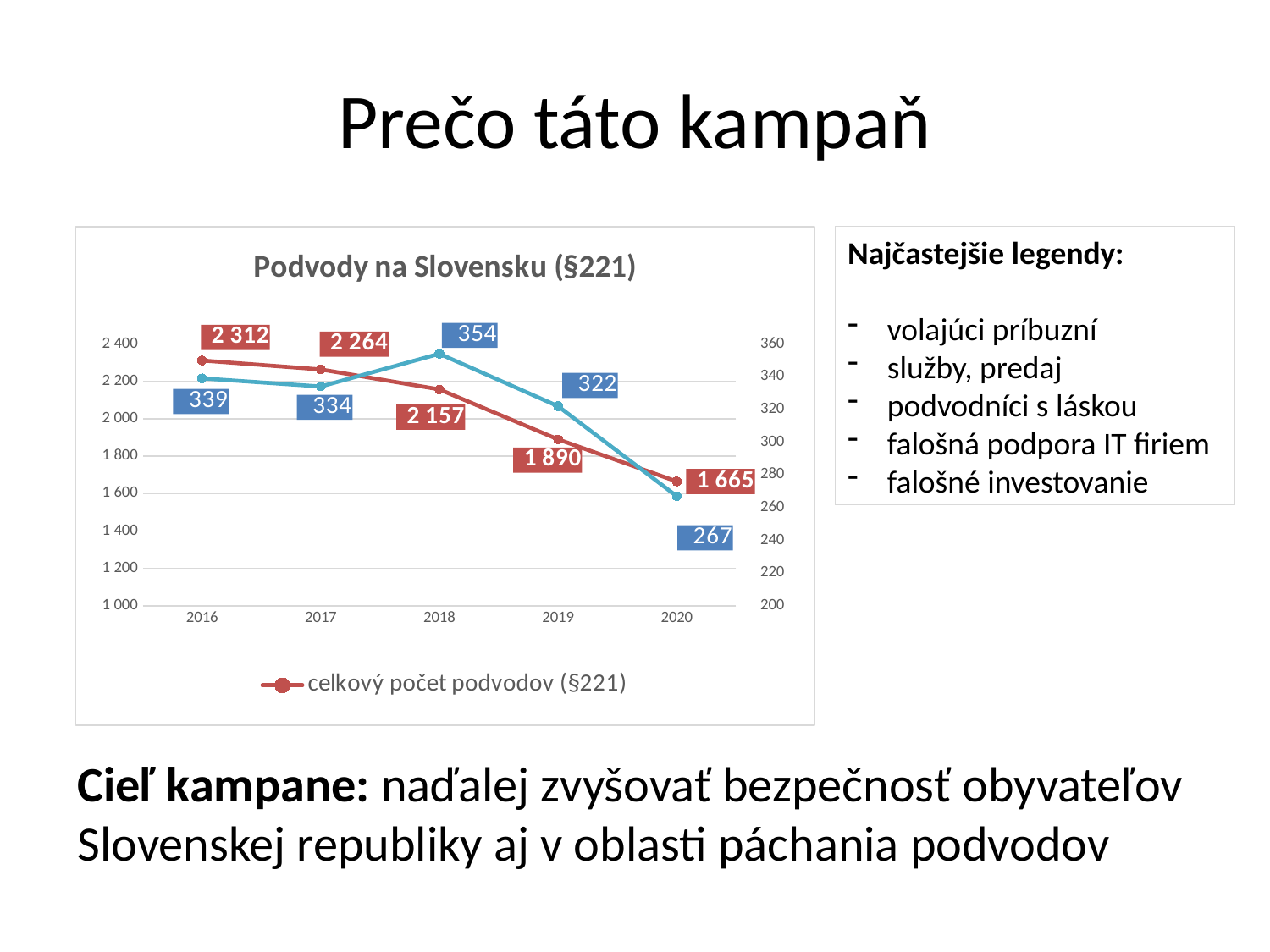
What is the value of celkový počet podvodov (§221) in 2020? 1 665 Which year has a larger value of celkový počet podvodov (§221), 2017 or 2019? 2017 In which year is celkový počet podvodov (§221) highest? 2016 Does celkový počet podvodov (§221) rise or fall from 2016 to 2020? fall What type of chart is shown on the slide? line chart What is the title of the chart? Podvody na Slovensku (§221) How many years are shown on the x axis of the chart? 5 What is the value of celkový počet podvodov (§221) in 2018? 2 157 In which year is celkový počet podvodov (§221) lowest? 2020 How many series does the chart legend list? 1 What is the difference between celkový počet podvodov (§221) in 2016 and in 2020? 647 What is the value of celkový počet podvodov (§221) in 2016? 2 312